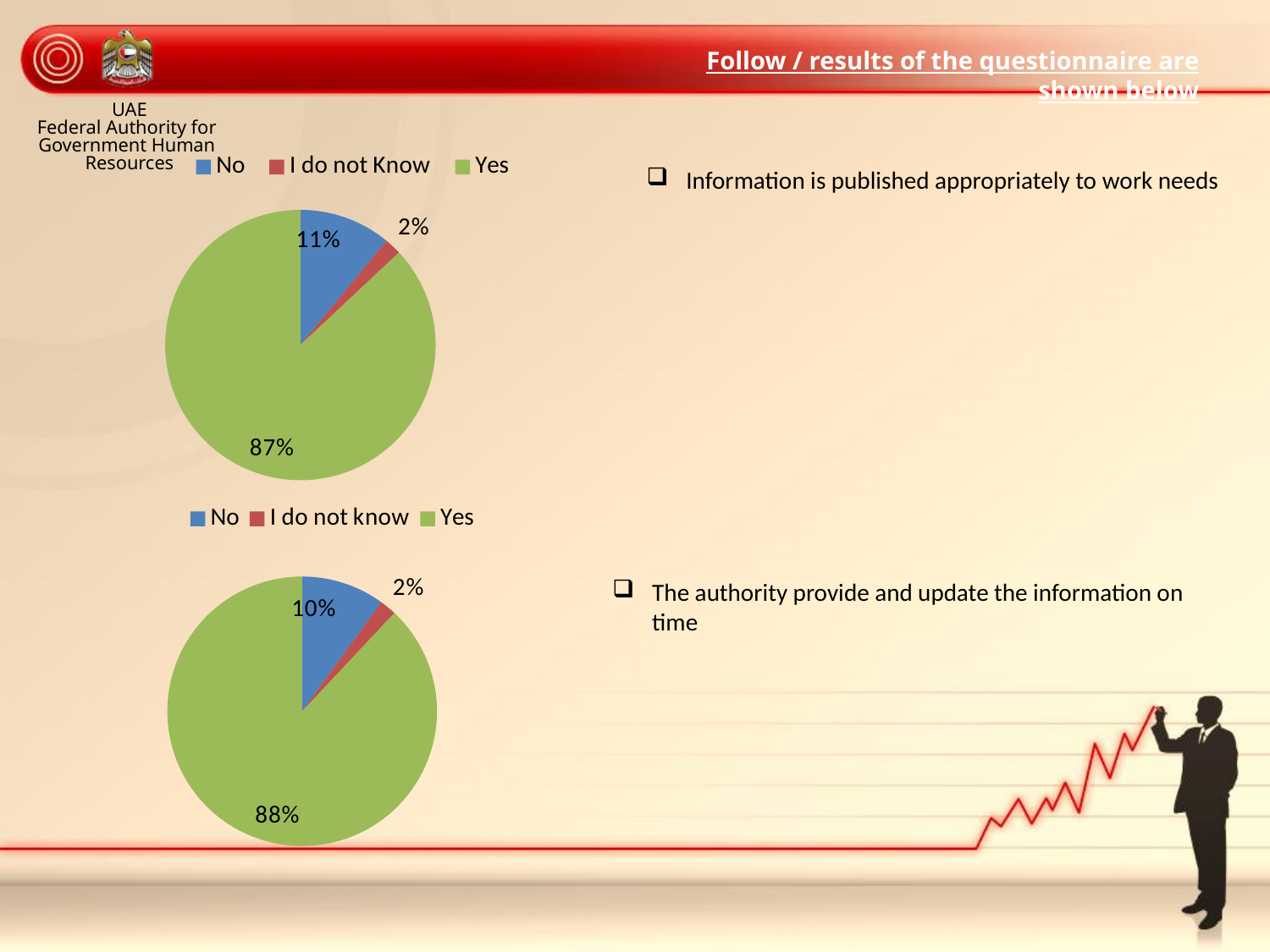
In the top pie chart, what percentage of respondents answered No? 11% What type of chart is the bottom chart on the slide? Pie chart In the bottom pie chart, what percentage of respondents answered Yes? 88% In the top pie chart, what is the difference between the Yes and No percentages? 76% In the bottom pie chart, which response has the largest share? Yes In the top pie chart, what percentage of respondents answered I do not Know? 2% In the bottom pie chart, what percentage of respondents answered No? 10% What colour represents Yes in the legend of the top chart? Green How many slices does the top pie chart have? 3 In the bottom pie chart, which is larger, the share for No or the share for I do not know? No In the top pie chart, what percentage of respondents answered Yes? 87% In the top pie chart, which response has the smallest share? I do not Know